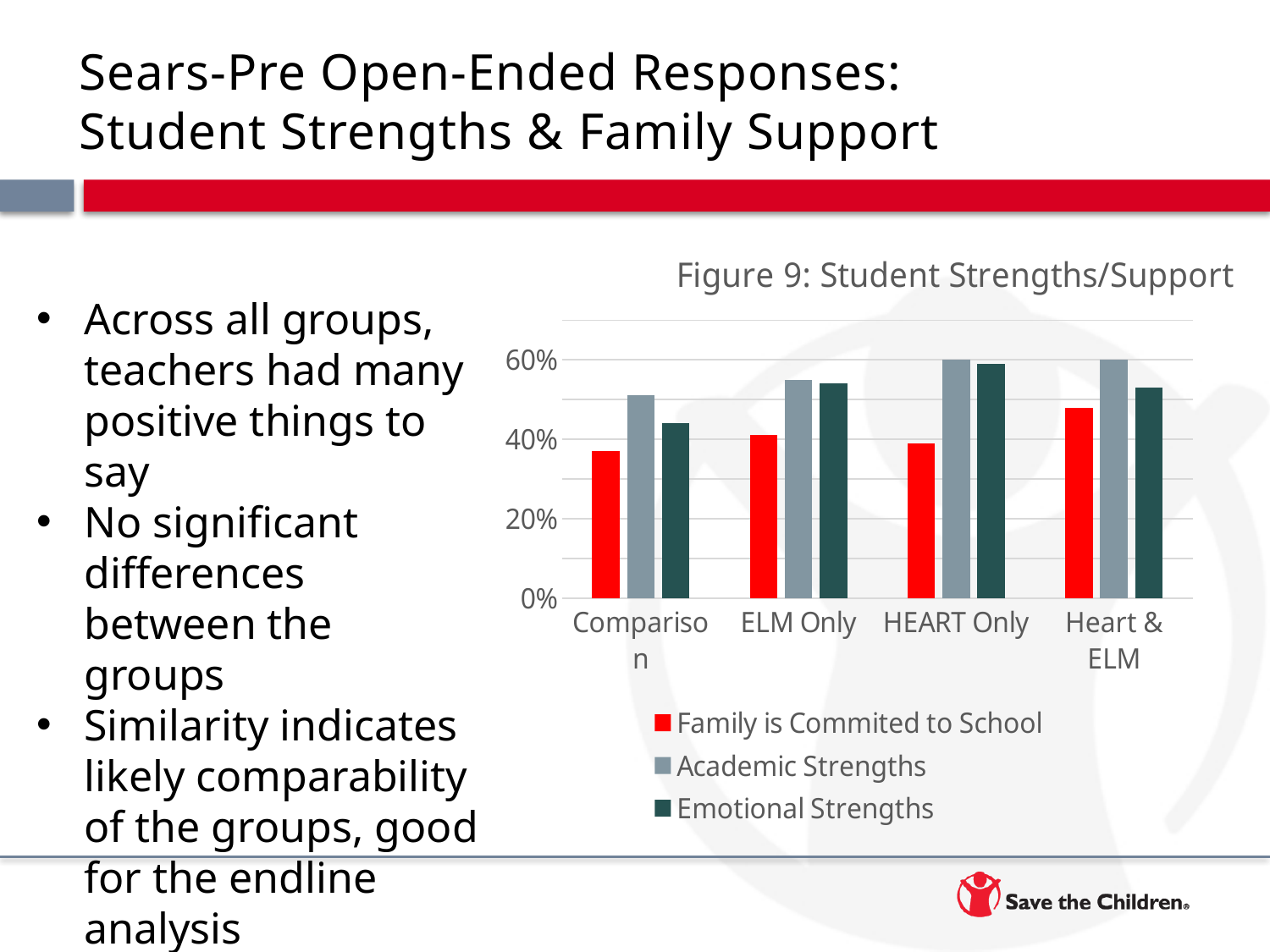
How many groups are shown on the x axis of the chart? 4 In the Comparison group, which series has the highest value? Academic Strengths Is the value for 'Family is Commited to School' in the Heart & ELM group greater or less than 40%? greater Is the value for 'Academic Strengths' in the ELM Only group greater or less than 40%? greater Is the value for 'Family is Commited to School' in the Comparison group greater or less than 40%? less What kind of chart is shown in Figure 9: Student Strengths/Support? bar chart Which colour represents 'Family is Commited to School' in the chart? red In the Comparison group, which is larger: 'Academic Strengths' or 'Family is Commited to School'? Academic Strengths Which group has the highest value for 'Family is Commited to School'? Heart & ELM How many series does the chart's legend list? 3 What is the title of the chart? Figure 9: Student Strengths/Support